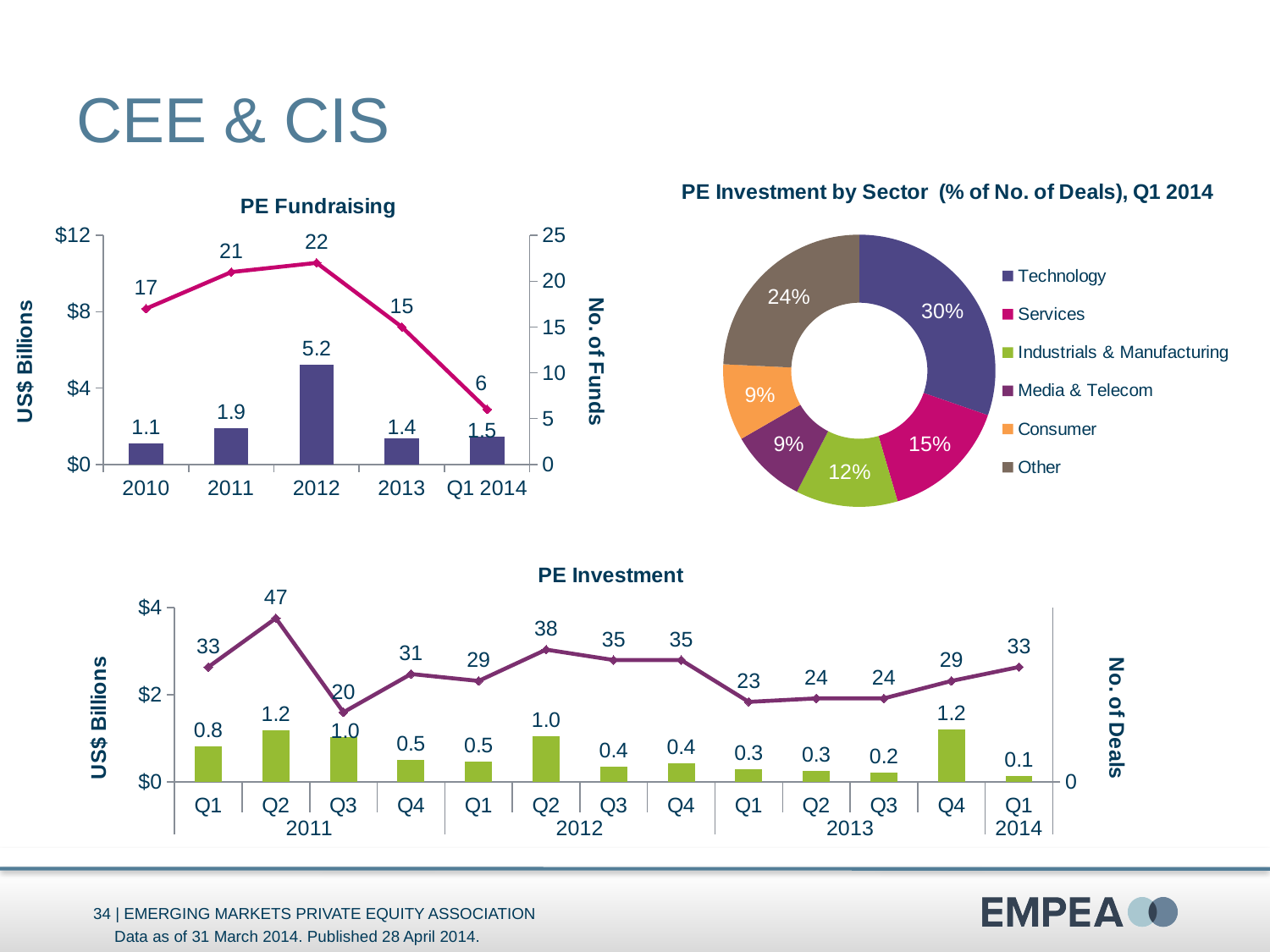
What kind of chart is the PE Investment by Sector chart? Doughnut (pie) chart In the PE Investment chart, what was the number of deals in Q2 2011? 47 In the PE Investment chart, what is the difference in number of deals between Q2 2011 and Q3 2011? 27 In the PE Fundraising chart, which year has the highest number of funds? 2012 In the PE Investment by Sector chart, which sector has the smallest share, Services or Industrials & Manufacturing? Industrials & Manufacturing In the PE Investment chart, which quarter has the lowest investment value in US$ billions? Q1 2014 In the PE Fundraising chart, how many periods are shown on the x axis? 5 In the PE Fundraising chart, what was the fundraising value in US$ billions for 2012? 5.2 In the PE Investment by Sector chart, what share of deals was in Technology? 30% In the PE Fundraising chart, what is the difference in US$ billions between 2012 and 2013 fundraising? 3.8 In the PE Fundraising chart, how many funds were raised in 2011? 21 How many sectors does the legend of the PE Investment by Sector chart list? 6